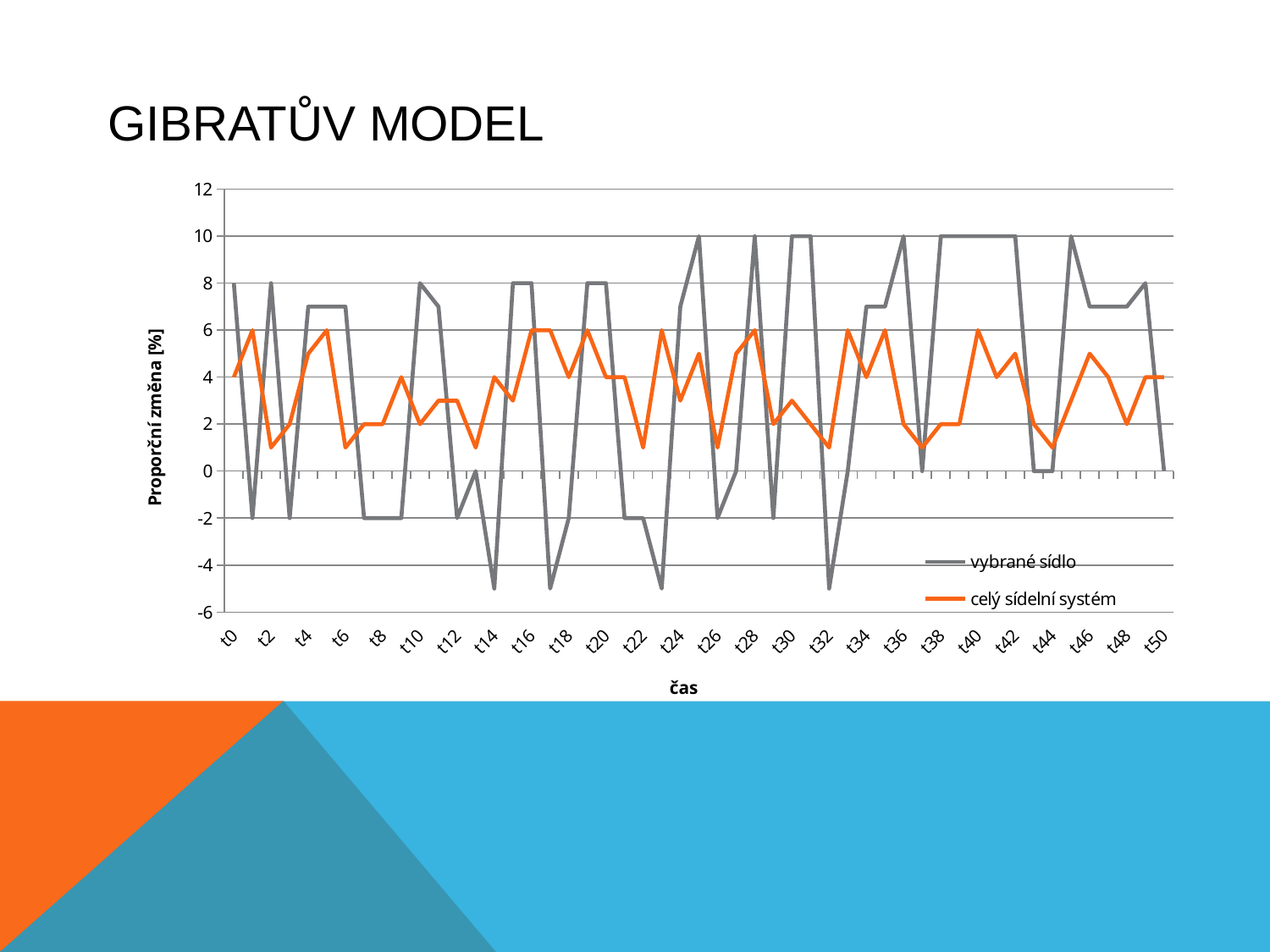
What is the label of the vertical axis? Proporční změna [%] Is the value for vybrané sídlo at t14 greater or less than -4? less What kind of chart is shown on the slide? line chart Which series has the higher value at t0, vybrané sídlo or celý sídelní systém? vybrané sídlo What is the value of celý sídelní systém at t0? 4 Which series has the higher value at t1, vybrané sídlo or celý sídelní systém? celý sídelní systém What are the two series named in the legend? vybrané sídlo, celý sídelní systém How many series does the legend list? 2 What is the value of vybrané sídlo at t0? 8 What is the value of vybrané sídlo at t1? -2 Is the value for vybrané sídlo at t25 greater or less than 8? greater What is the highest value reached by the vybrané sídlo series? 10